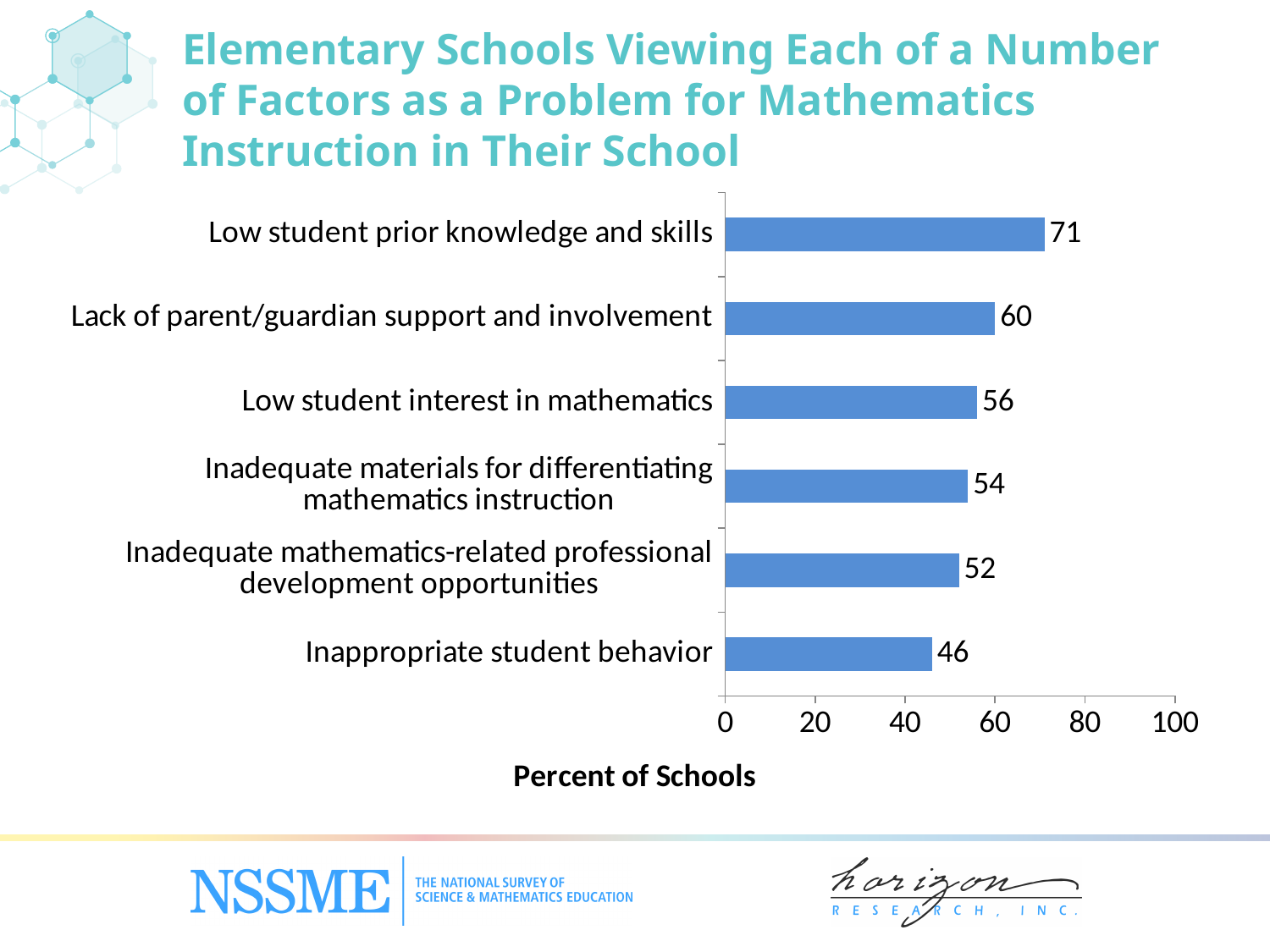
Which is larger: the value for lack of parent/guardian support and involvement or the value for low student interest in mathematics? Lack of parent/guardian support and involvement What is the value for lack of parent/guardian support and involvement? 60 What is the value for inappropriate student behavior? 46 Which factor has the lowest percent of schools viewing it as a problem? Inappropriate student behavior What is the difference between the values for low student interest in mathematics and inadequate materials for differentiating mathematics instruction? 2 How many factors are shown in the chart? 6 Which factor has the highest percent of schools viewing it as a problem? Low student prior knowledge and skills Is the value for inappropriate student behavior greater or less than 60? less What is the difference between the values for low student prior knowledge and skills and inappropriate student behavior? 25 What is the value for inadequate mathematics-related professional development opportunities? 52 What kind of chart is shown on the slide? Bar chart What percent of schools view low student prior knowledge and skills as a problem? 71